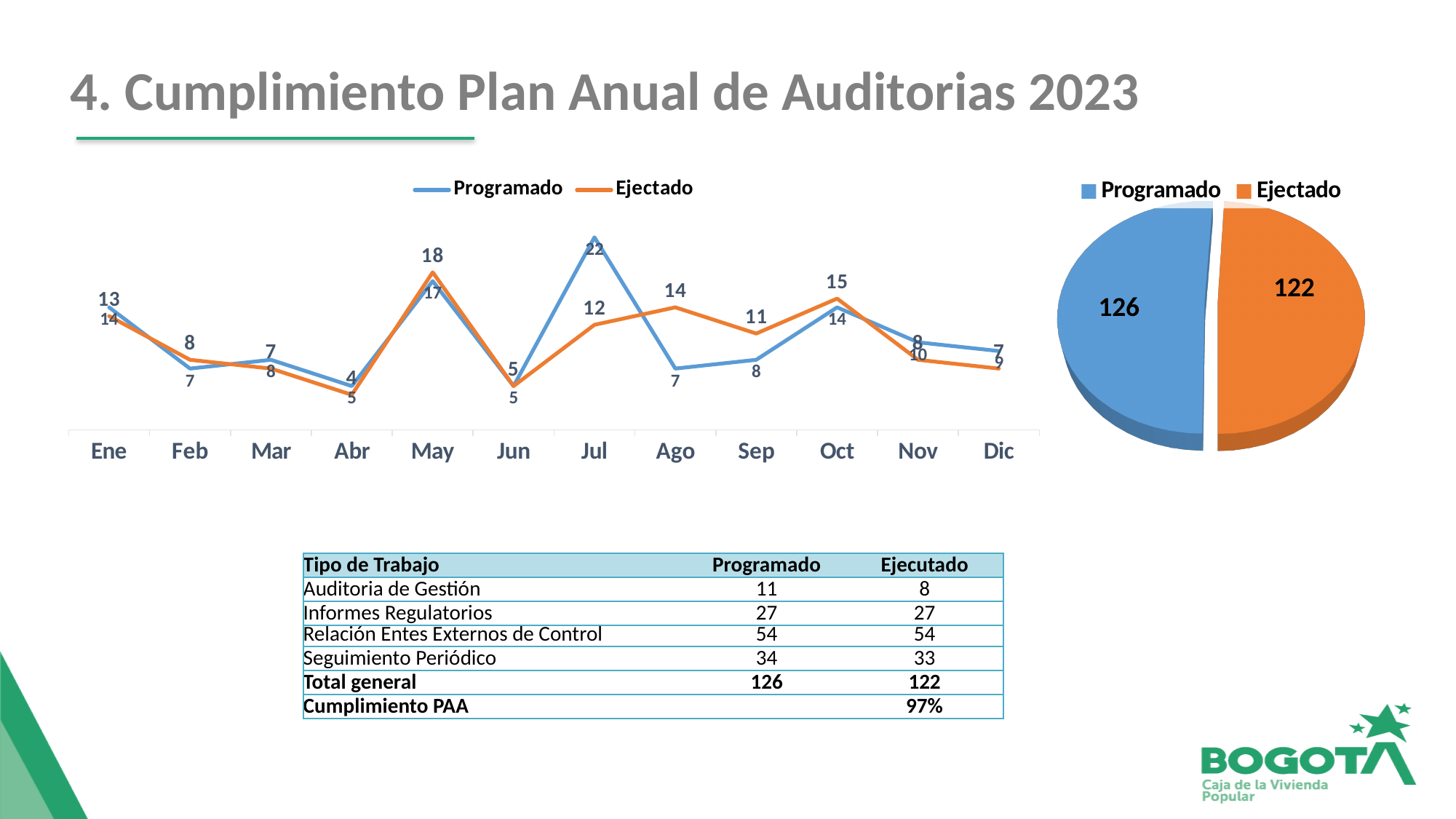
In the pie chart on the right, what is the value of the Programado slice? 126 In the line chart on the left, which is larger for Ago: Programado or Ejectado? Ejectado In the line chart on the left, what is the difference between the Programado and Ejectado values for Jul? 10 In the line chart on the left, what is the Ejectado value for May? 18 In the line chart on the left, which month has the highest Programado value? Jul In the line chart on the left, which month has the highest Ejectado value? May How many series does the legend of the line chart on the left list? 2 In the line chart on the left, what is the Ejectado value for Ago? 14 In the line chart on the left, which month has the lowest Programado value? Abr and Jun (tied at 5) In the line chart on the left, what is the Programado value for Jul? 22 What kind of chart is the chart on the right of the slide? Pie chart How many months are shown on the x axis of the line chart on the left? 12